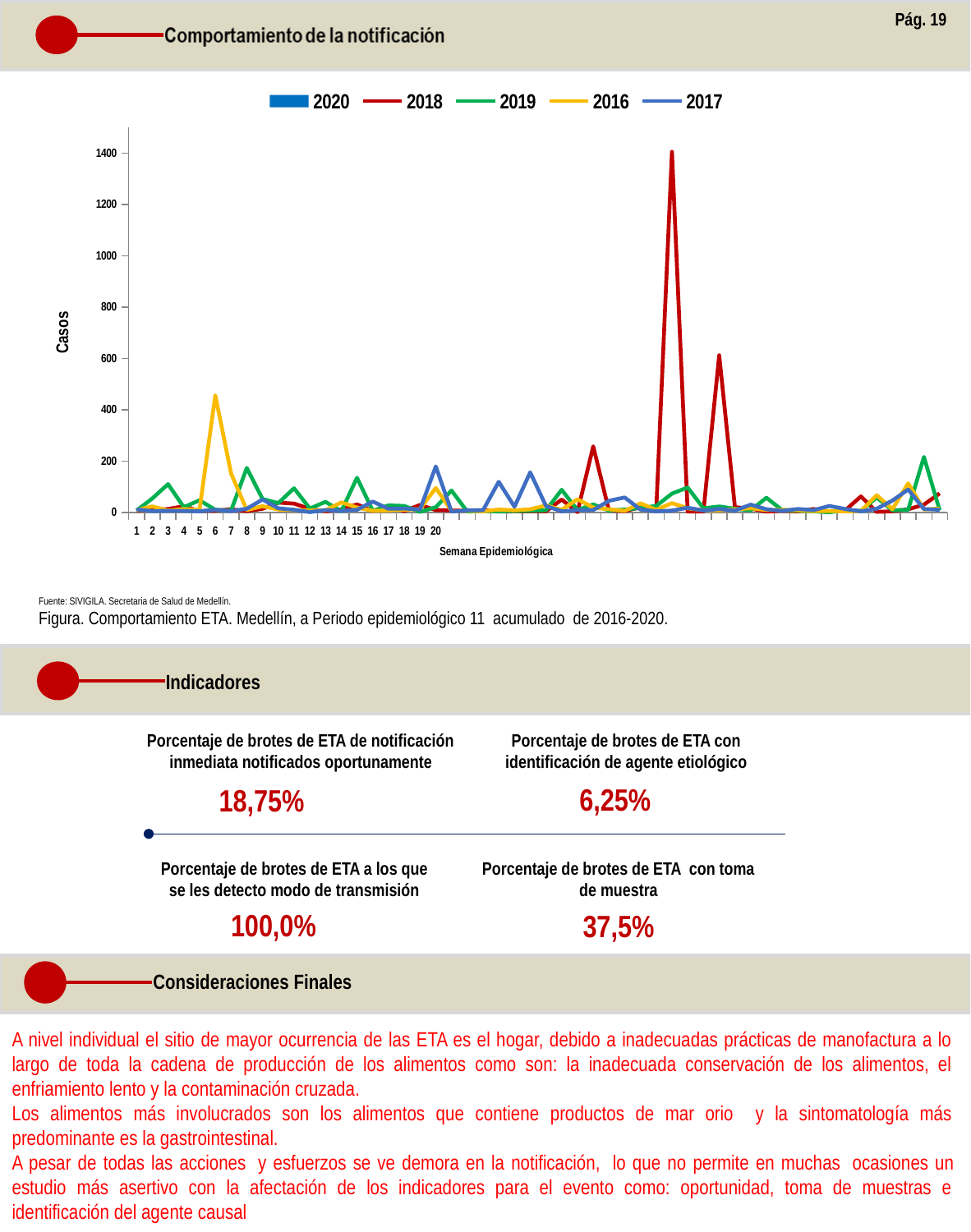
What kind of chart is shown on the slide? line chart What is the highest tick value shown on the vertical axis? 1400 What is the title of the vertical axis of the chart? Casos Which years are listed in the chart legend? 2020, 2018, 2019, 2016, 2017 Which series has the highest value around week 6? 2016 Which is larger: the highest peak of the 2018 series or the highest peak of the 2016 series? 2018 How many series does the chart legend list? 5 Which series reaches the highest value on the chart? 2018 Is the peak of the 2016 series at week 6 greater or less than 400? greater Is the peak of the 2016 series at week 6 greater or less than 600? less Is the second-highest peak of the 2018 series greater or less than 800? less